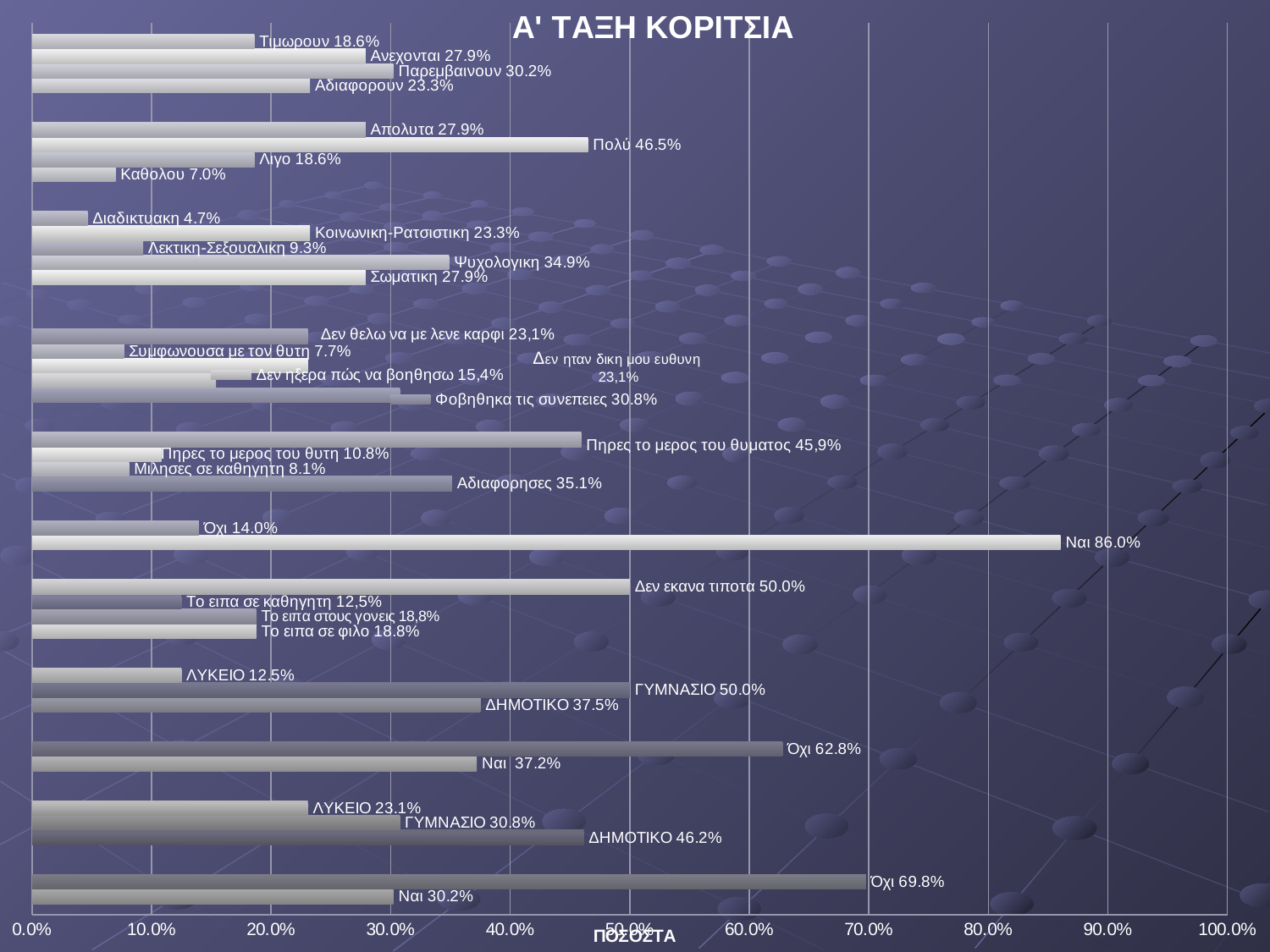
What is the title of the chart? Α' ΤΑΞΗ ΚΟΡΙΤΣΙΑ What is the difference between the values for "Πολύ" and "Καθολου"? 39.5% Which is larger, the value for "Σωματικη" or the value for "Ψυχολογικη"? Ψυχολογικη What is the value for "Φοβηθηκα τις συνεπειες"? 30.8% Which bar has the lowest value on the chart? Διαδικτυακη 4.7% What is the value for "Δεν εκανα τιποτα"? 50.0% What kind of chart is shown on the slide? bar chart What is the label of the horizontal axis? ΠΟΣΟΣΤΑ What is the value for "Ψυχολογικη"? 34.9% Which bar has the highest value on the chart? Ναι 86.0% What is the value for "Διαδικτυακη"? 4.7% What is the value for "Πολύ"? 46.5%